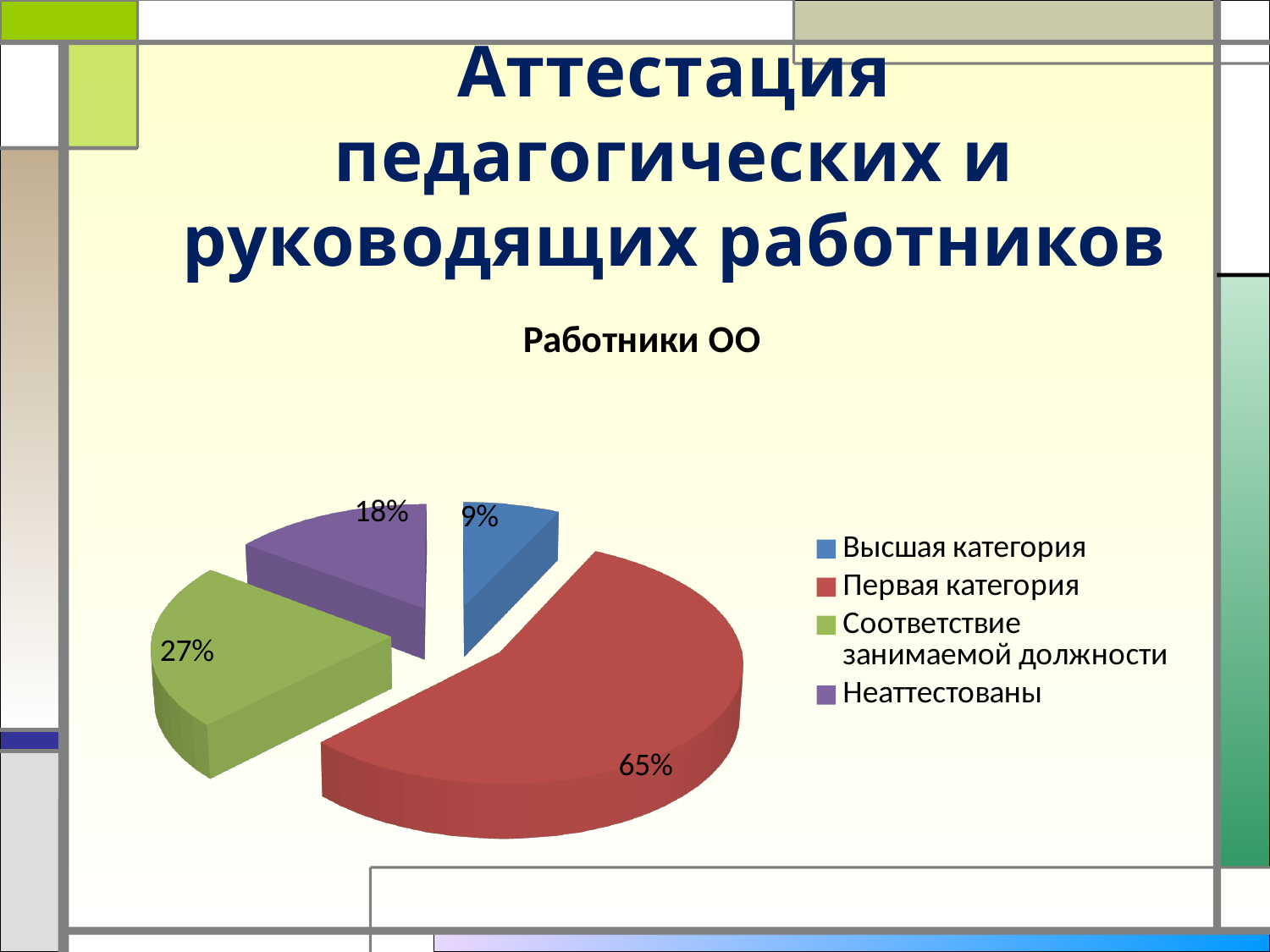
What is the difference between the shares for Первая категория and Соответствие занимаемой должности? 38% Which category has the largest slice of the pie? Первая категория What share of the pie is labelled Высшая категория? 9% What kind of chart is shown on the slide? Pie chart What share of the pie is labelled Соответствие занимаемой должности? 27% What share of the pie is labelled Неаттестованы? 18% What colour is the slice for Неаттестованы? Purple Which is larger: the share for Неаттестованы or the share for Высшая категория? Неаттестованы How many categories does the pie chart have? 4 Which category has the smallest slice of the pie? Высшая категория What is the title of the chart? Работники ОО